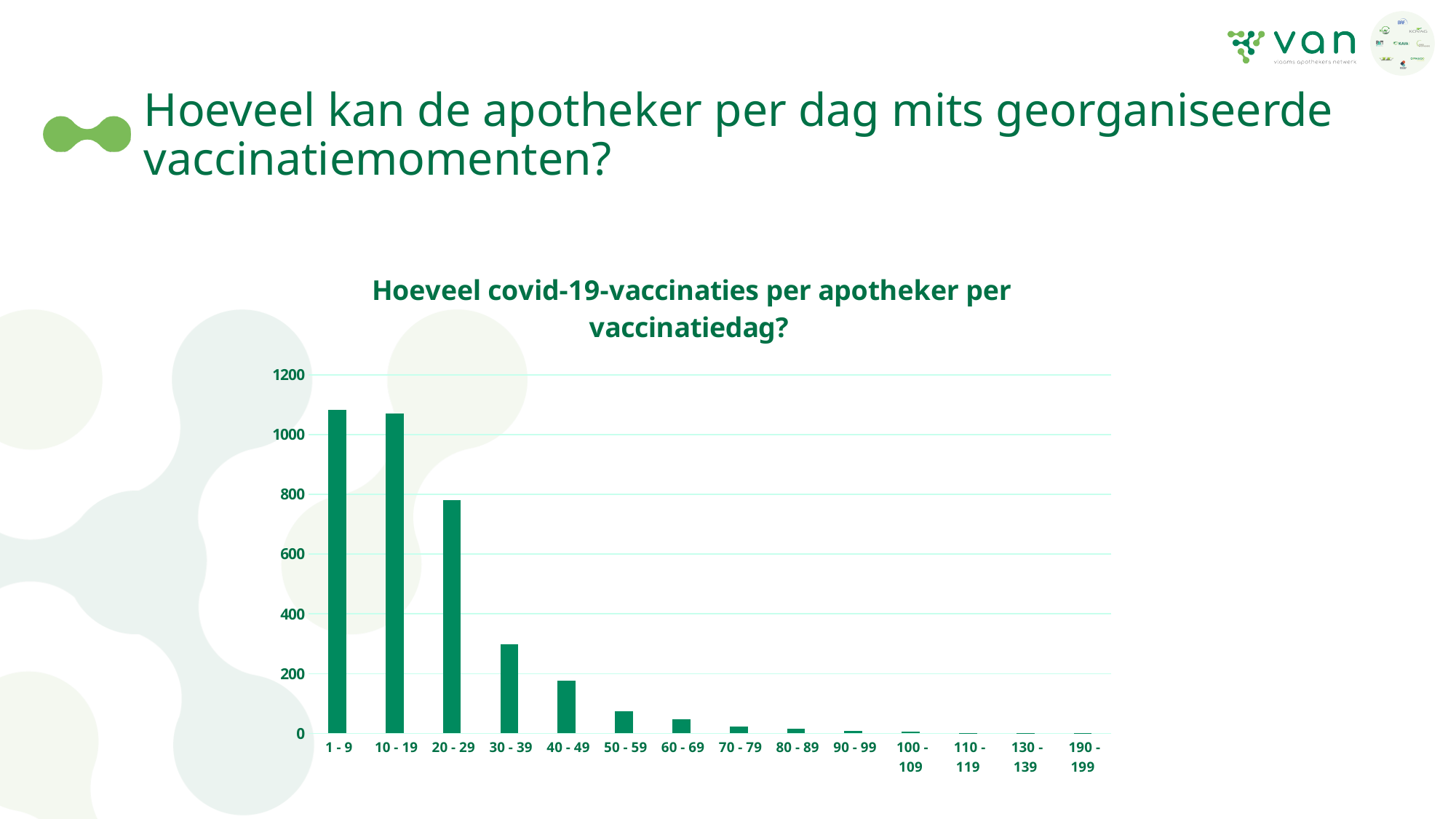
How many categories are shown on the x axis of the chart? 14 Which category has the larger value, 30 - 39 or 40 - 49? 30 - 39 What kind of chart is shown on the slide? bar chart What is the title of the chart? Hoeveel covid-19-vaccinaties per apotheker per vaccinatiedag? Is the value for the 30 - 39 category greater or less than 200? greater Is the value for the 50 - 59 category greater or less than 200? less Do the values generally rise or fall moving from left to right along the x axis? fall Is the value for the 40 - 49 category greater or less than 200? less What is the highest value shown on the y axis of the chart? 1200 Which category has the larger value, 20 - 29 or 30 - 39? 20 - 29